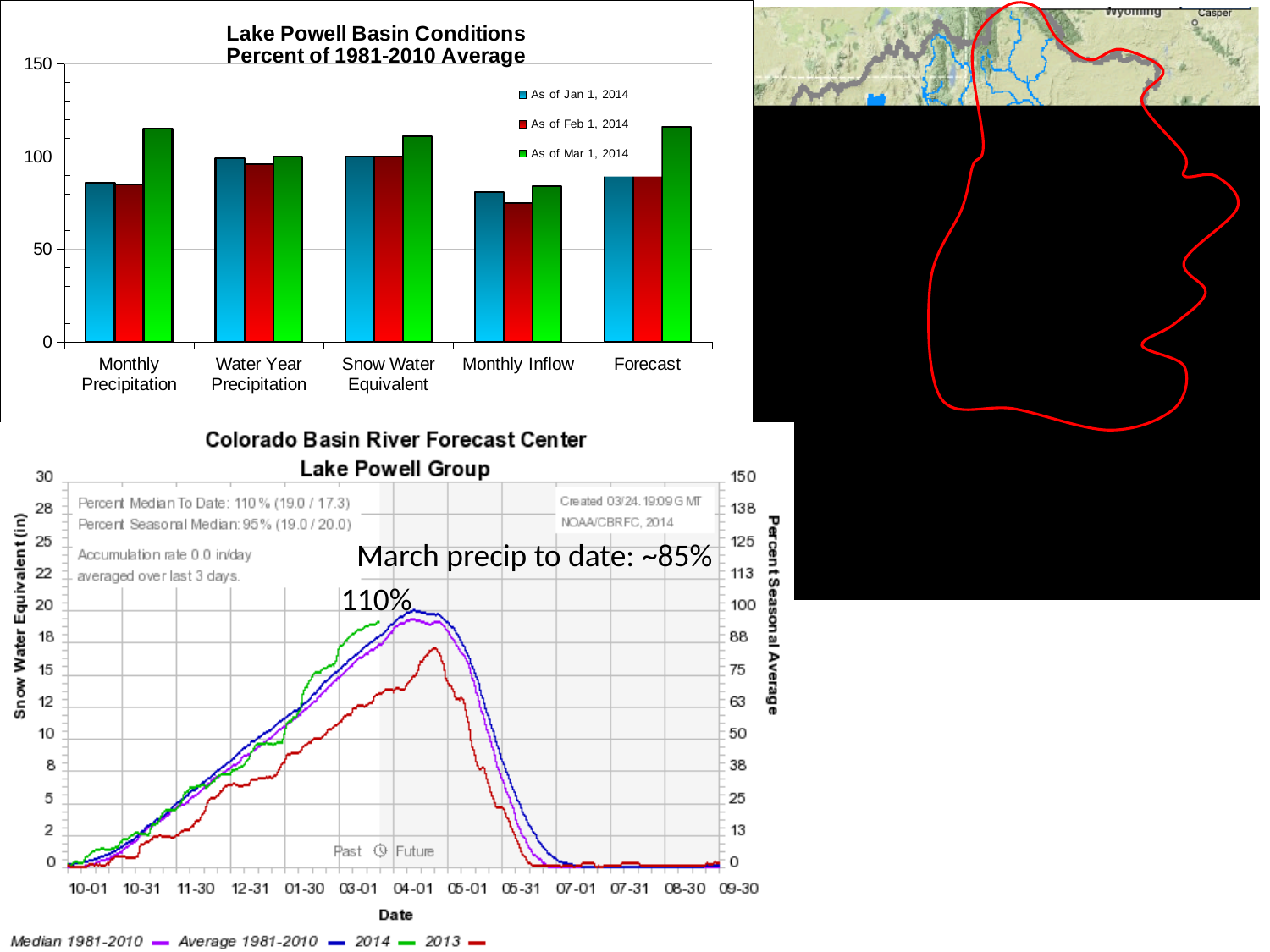
How many categories are shown on the x axis of the 'Lake Powell Basin Conditions' chart? 5 In the 'Lake Powell Basin Conditions' chart, which category has the lowest 'As of Mar 1, 2014' value? Monthly Inflow What kind of chart is the 'Lake Powell Basin Conditions' chart at the top left of the slide? bar chart In the 'Lake Powell Basin Conditions' chart, for Monthly Precipitation, which is larger: the 'As of Jan 1, 2014' value or the 'As of Mar 1, 2014' value? As of Mar 1, 2014 In the 'Lake Powell Basin Conditions' chart, is the 'As of Feb 1, 2014' value for Monthly Inflow greater or less than 100? less What kind of chart is the 'Colorado Basin River Forecast Center Lake Powell Group' chart at the bottom of the slide? line chart How many series does the legend of the 'Colorado Basin River Forecast Center Lake Powell Group' chart list? 4 In the 'Lake Powell Basin Conditions' chart, which category has the lowest 'As of Feb 1, 2014' value? Monthly Inflow In the 'Lake Powell Basin Conditions' chart, is the 'As of Mar 1, 2014' value for Forecast greater or less than 100? greater What is the label of the left y axis of the 'Colorado Basin River Forecast Center Lake Powell Group' chart? Snow Water Equivalent (in) In the 'Lake Powell Basin Conditions' chart, is the 'As of Mar 1, 2014' value for Monthly Precipitation greater or less than 100? greater How many series does the legend of the 'Lake Powell Basin Conditions' chart list? 3